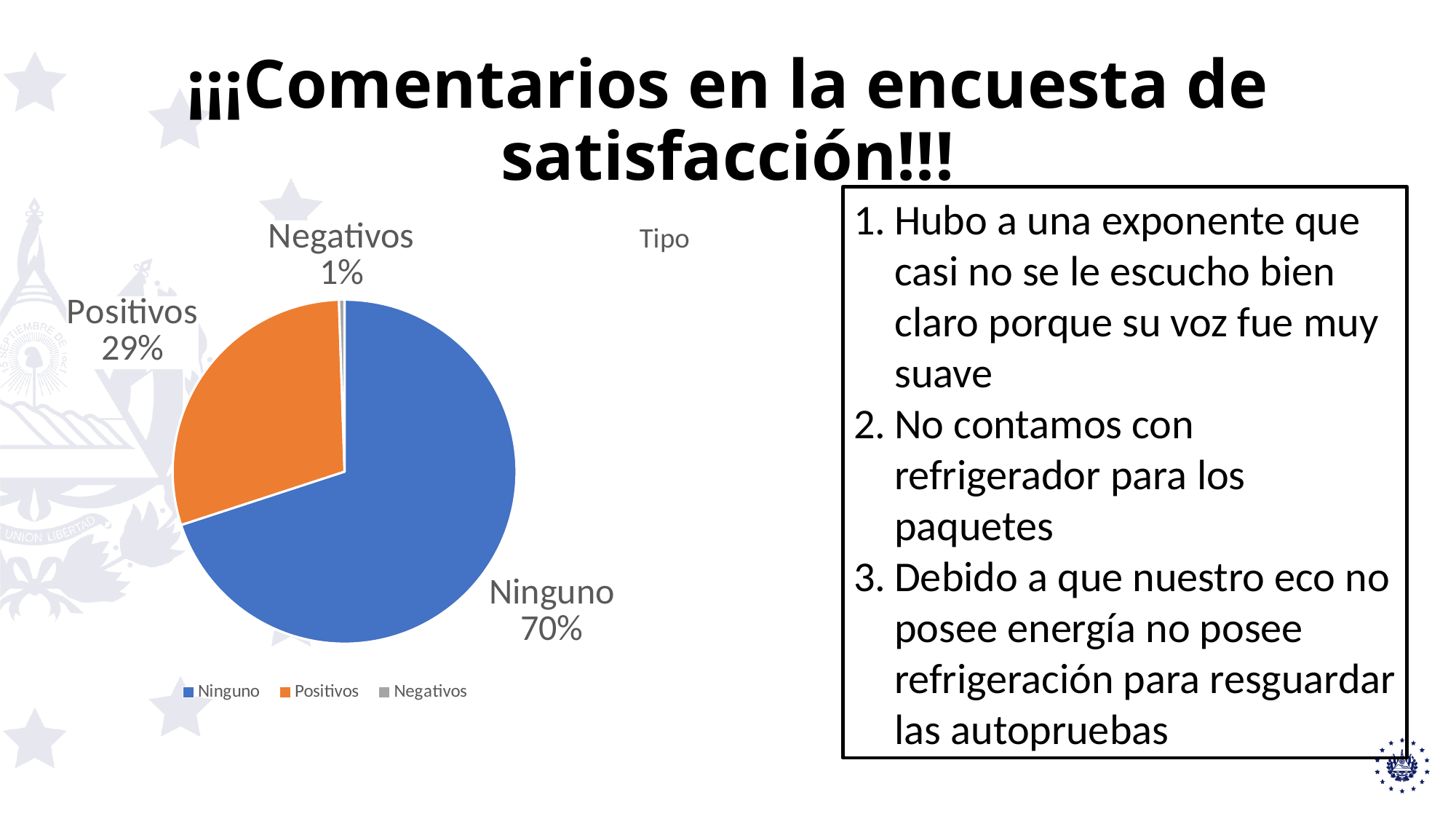
Which category has the largest slice of the pie? Ninguno Which category has the smallest slice of the pie? Negativos How many entries does the legend list? 3 How many categories are shown in the pie chart? 3 What is the title of the chart? Tipo What colour is the Positivos slice? orange What type of chart is shown on the slide? pie chart Which slice is larger, Positivos or Negativos? Positivos What percentage of the pie does the Ninguno slice represent? 70% What percentage of the pie does the Positivos slice represent? 29% What is the difference in percentage points between the Ninguno and Positivos slices? 41 What percentage of the pie does the Negativos slice represent? 1%